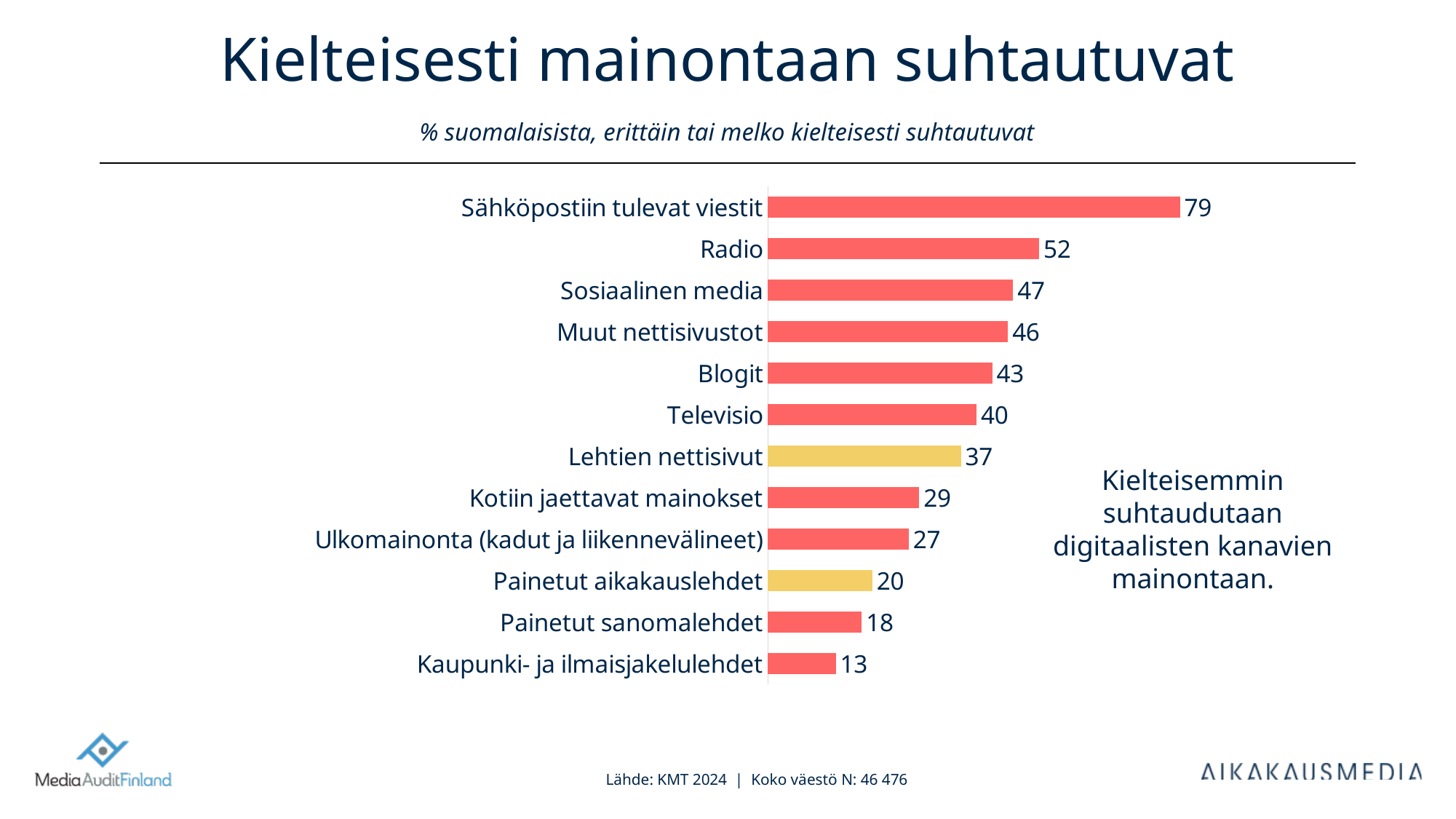
How many categories are shown in the chart? 12 Which category has the lowest value? Kaupunki- ja ilmaisjakelulehdet What is the difference between the values for Sähköpostiin tulevat viestit and Kaupunki- ja ilmaisjakelulehdet? 66 What is the value for Lehtien nettisivut? 37 Which is larger, the value for Blogit or the value for Kotiin jaettavat mainokset? Blogit What is the value for Sähköpostiin tulevat viestit? 79 Which category has the highest value? Sähköpostiin tulevat viestit What kind of chart is shown on the slide? Bar chart Which two categories are shown with yellow bars instead of red? Lehtien nettisivut and Painetut aikakauslehdet What is the value for Painetut aikakauslehdet? 20 Which is larger, the value for Painetut sanomalehdet or the value for Painetut aikakauslehdet? Painetut aikakauslehdet What is the difference between the values for Radio and Televisio? 12